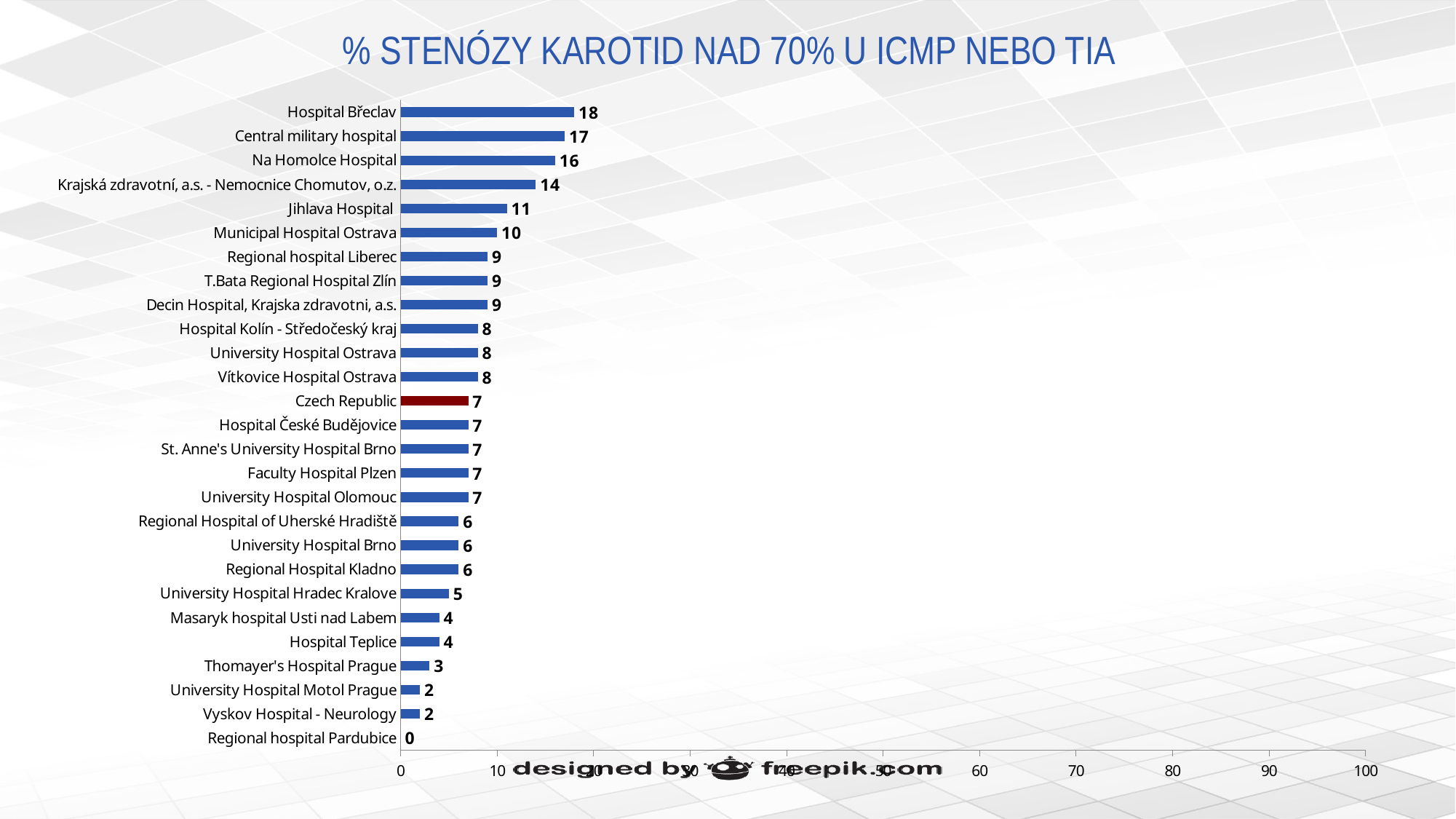
Which category has the highest value? Hospital Břeclav How many categories are shown in the chart? 27 Is the value for Krajská zdravotní, a.s. - Nemocnice Chomutov, o.z. greater or less than 10? greater Which bar is shown in a different colour (dark red) from the others? Czech Republic What is the value for Hospital Břeclav? 18 What is the difference between the values for Hospital Břeclav and Na Homolce Hospital? 2 Which is larger, the value for Municipal Hospital Ostrava or the value for Hospital Teplice? Municipal Hospital Ostrava What is the value for University Hospital Motol Prague? 2 What is the value for Czech Republic? 7 Which category has the lowest value? Regional hospital Pardubice What kind of chart is shown on the slide? bar chart What is the value for Jihlava Hospital? 11